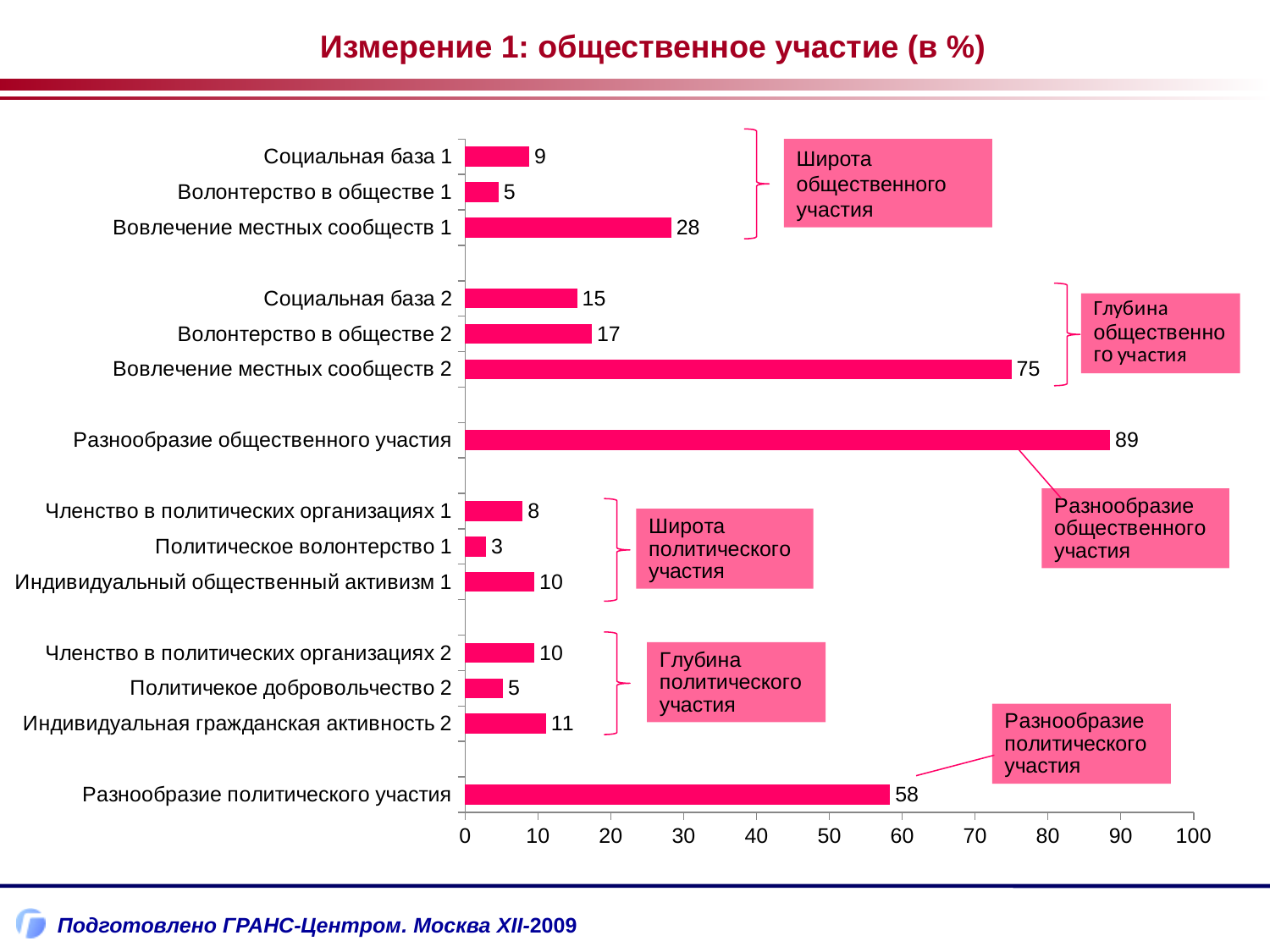
Which category has the lowest value? Политическое волонтерство 1 What is the difference between Вовлечение местных сообществ 2 and Вовлечение местных сообществ 1? 47 What is the difference between Разнообразие общественного участия and Разнообразие политического участия? 31 What is the value for Социальная база 2? 15 How many categories (bars) are plotted in the chart? 14 What is the value for Политическое волонтерство 1? 3 What is the value for Вовлечение местных сообществ 2? 75 Which category has the highest value? Разнообразие общественного участия Which is larger, Волонтерство в обществе 2 or Социальная база 2? Волонтерство в обществе 2 What is the value for Разнообразие политического участия? 58 What type of chart is shown on the slide? bar chart What is the title of the slide? Измерение 1: общественное участие (в %)